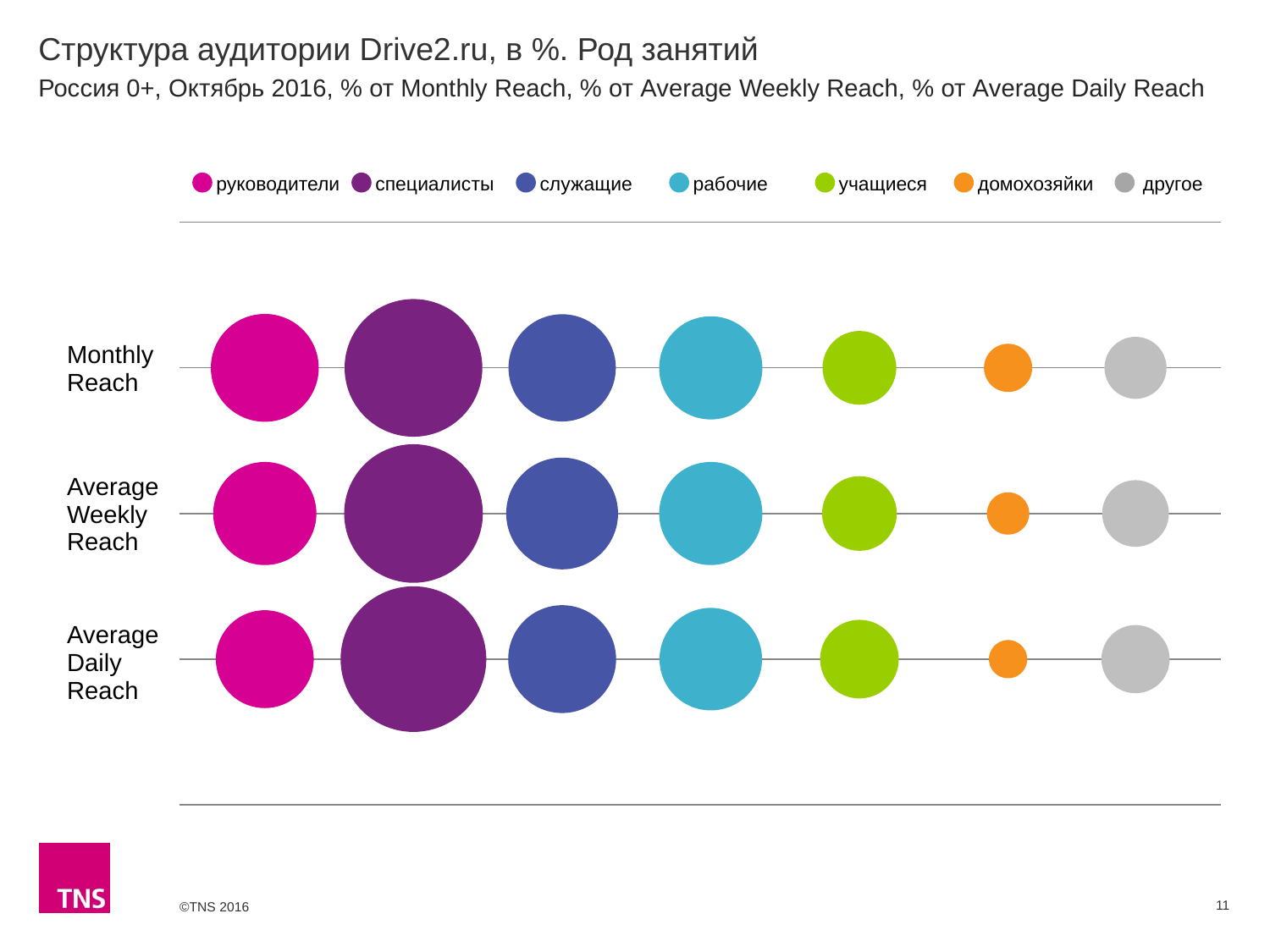
Which occupation category has the largest bubble in the Average Daily Reach row? специалисты Which occupation category has the smallest bubble in the Average Weekly Reach row? домохозяйки How many occupation categories does the legend list? 7 In the Average Weekly Reach row, which bubble is larger: специалисты or служащие? специалисты Which occupation category has the smallest bubble in the Monthly Reach row? домохозяйки In the Monthly Reach row, which bubble is larger: руководители or учащиеся? руководители In the Average Daily Reach row, which bubble is larger: другое or домохозяйки? другое What kind of chart is shown on the slide? bubble chart What is the title of the chart on the slide? Структура аудитории Drive2.ru, в %. Род занятий What colour are the bubbles for специалисты? purple Which occupation category has the largest bubble in the Monthly Reach row? специалисты How many reach rows (Monthly, Weekly, Daily) are plotted on the chart? 3